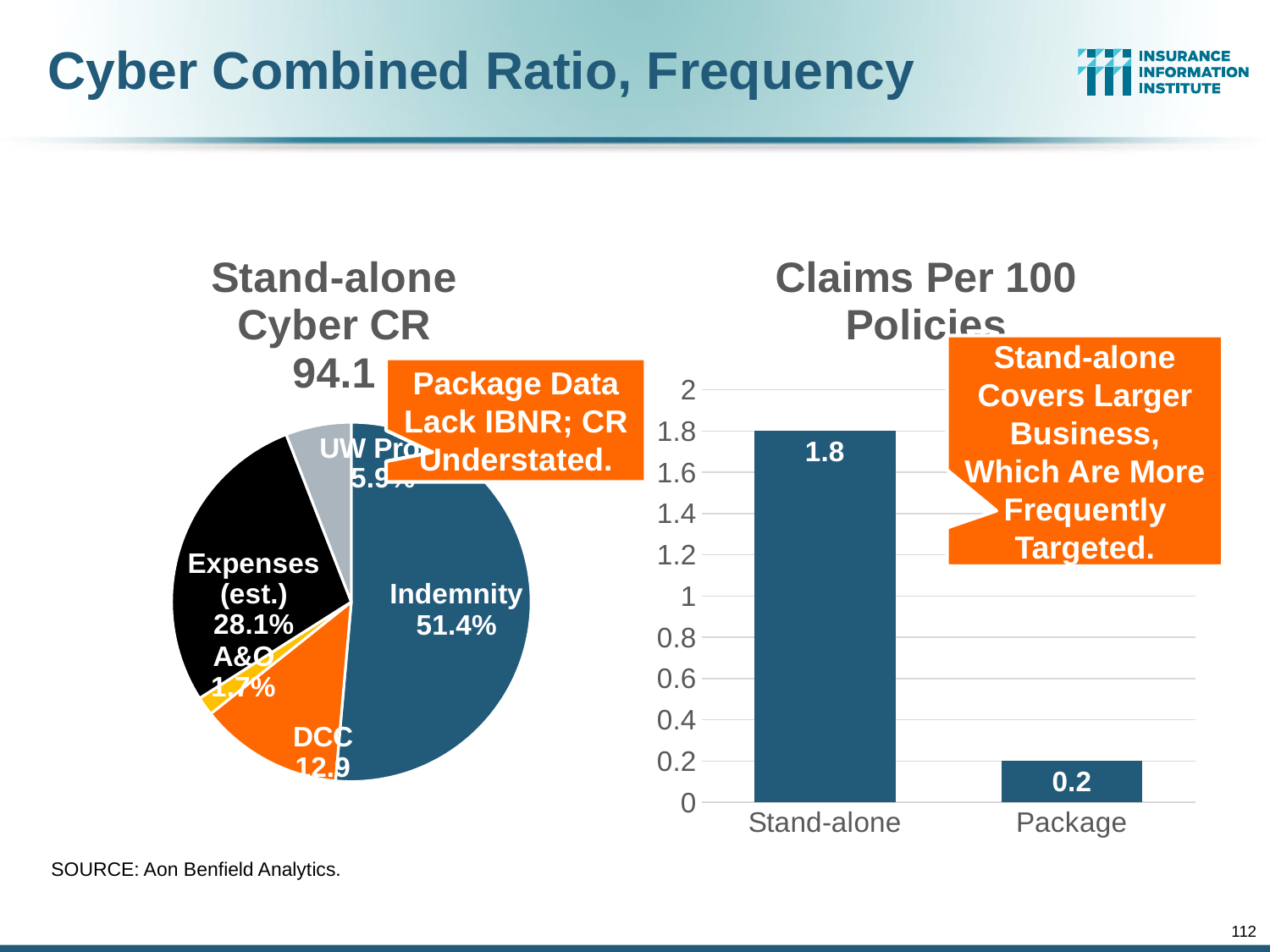
In the 'Claims Per 100 Policies' chart, which category has the higher value? Stand-alone In the 'Stand-alone Cyber CR' pie chart, which slice is the largest? Indemnity In the 'Claims Per 100 Policies' chart, what is the difference between the Stand-alone and Package values? 1.6 How many categories are shown in the 'Claims Per 100 Policies' bar chart? 2 What kind of chart is the 'Claims Per 100 Policies' chart on the right? Bar chart What kind of chart is the 'Stand-alone Cyber CR' chart on the left? Pie chart In the 'Stand-alone Cyber CR' pie chart, what share does Indemnity have? 51.4% In the 'Stand-alone Cyber CR' pie chart, which is larger: Indemnity or Expenses (est.)? Indemnity In the 'Claims Per 100 Policies' chart, what is the value for Package? 0.2 What combined ratio value is shown in the title of the pie chart on the left? 94.1 In the 'Claims Per 100 Policies' chart, what is the value for Stand-alone? 1.8 In the 'Stand-alone Cyber CR' pie chart, what share does Expenses (est.) have? 28.1%